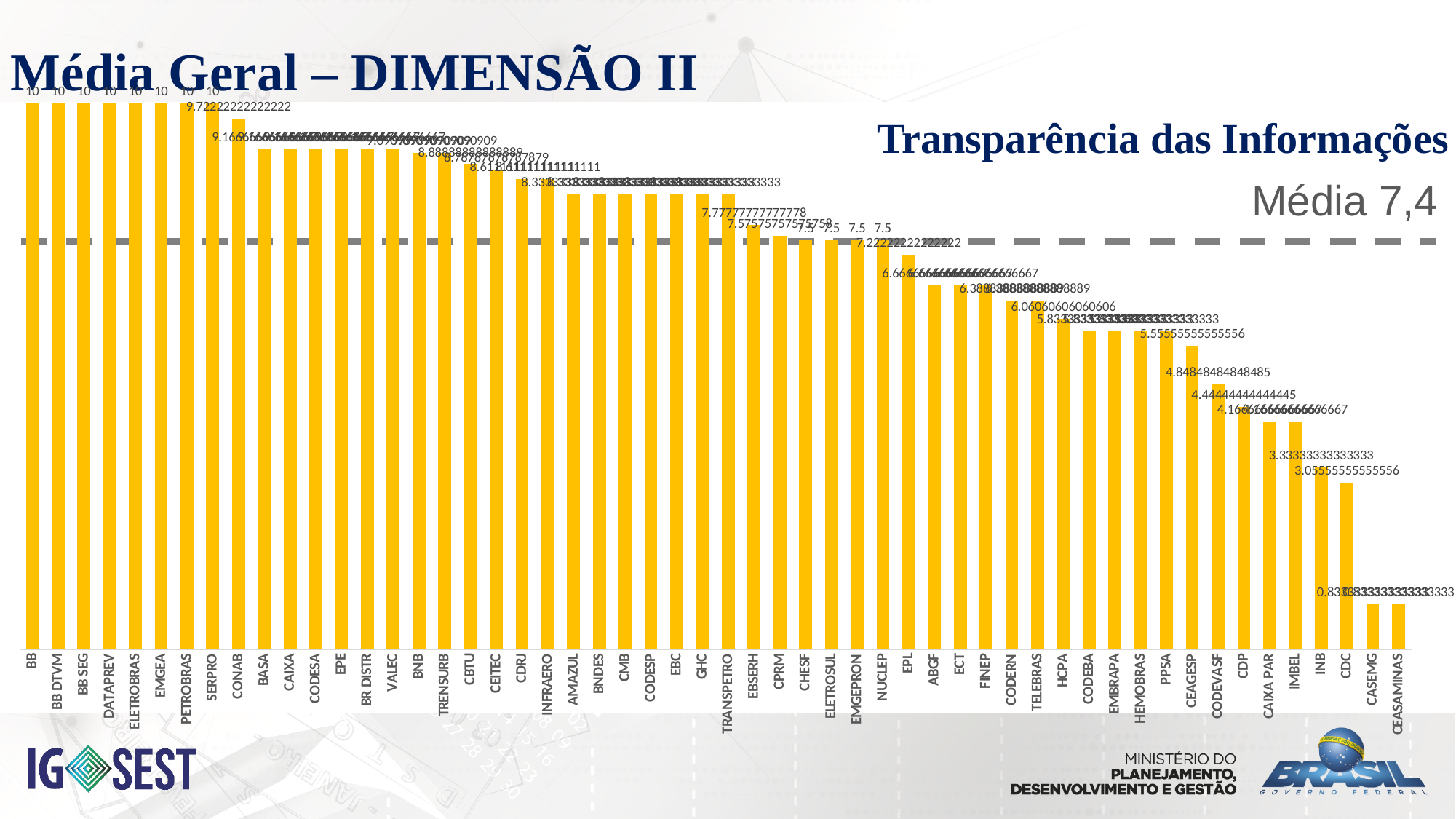
What is the value for CODEVASF? 4.84848484848485 What kind of chart is shown on the slide? bar chart What is the value for INB? 3.33333333333333 What is the value for BB? 10 What is the value for CONAB? 9.72222222222222 Is the value for CDC greater or less than the average line of 7,4? less Which has the larger value, CONAB or CDC? CONAB How many companies (bars) are shown in the chart? 54 What is the value for CDC? 3.05555555555556 What is the value for PETROBRAS? 10 Do the values rise or fall from left to right along the x axis? fall What average value (Média) is indicated by the dashed line on the chart? 7,4